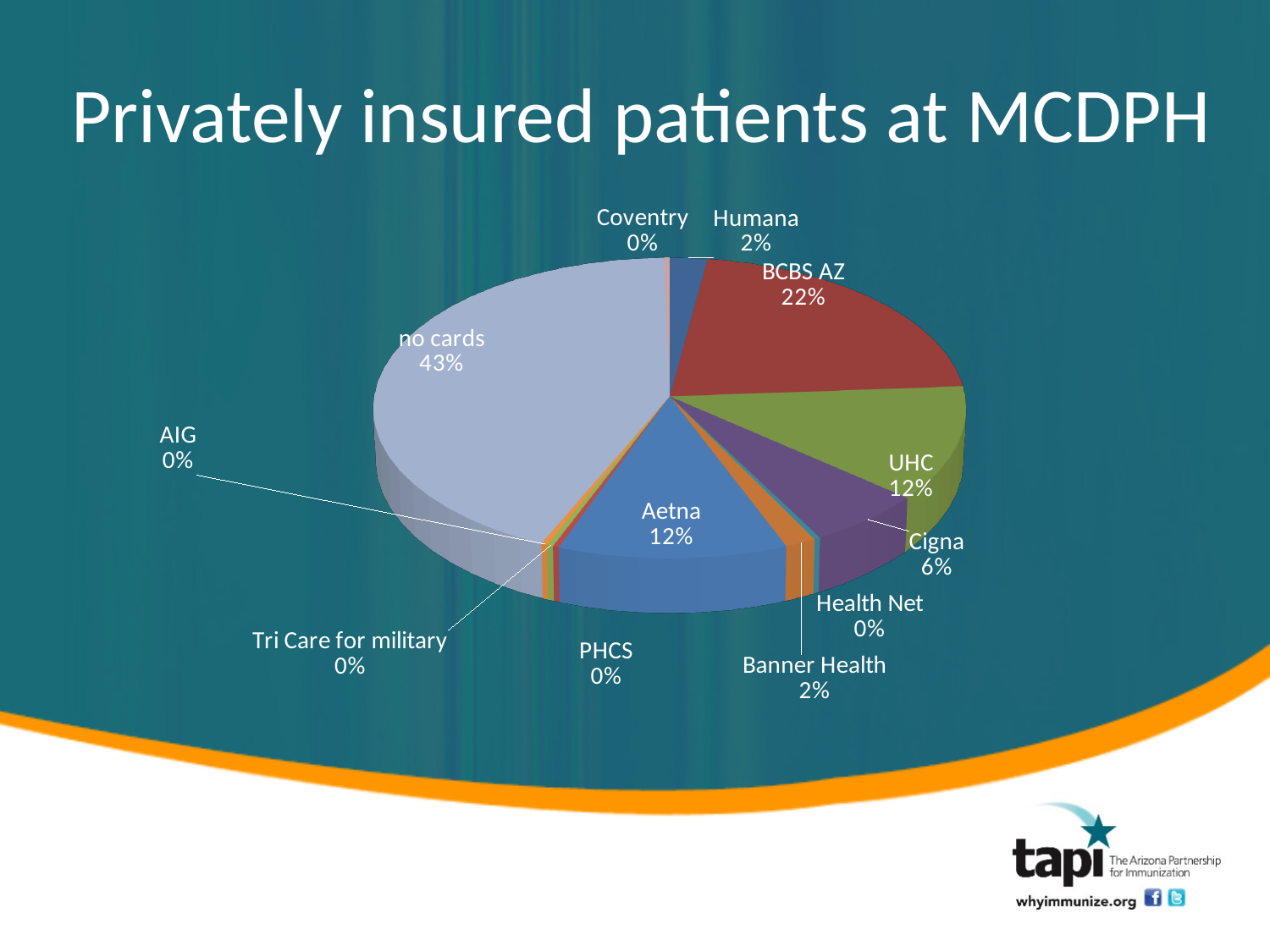
How many categories are labelled on the pie chart? 12 What percentage is shown for BCBS AZ? 22% What percentage is shown for Banner Health? 2% What is the combined share of Aetna and UHC? 24% What percentage is shown for Tri Care for military? 0% What share of the pie is labelled "no cards"? 43% What kind of chart is shown on the slide? pie chart Which is larger, the share for Cigna or the share for Humana? Cigna What is the difference between the BCBS AZ share and the UHC share? 10% What percentage is shown for Cigna? 6% Which category has the largest slice of the pie? no cards What is the title of the chart? Privately insured patients at MCDPH